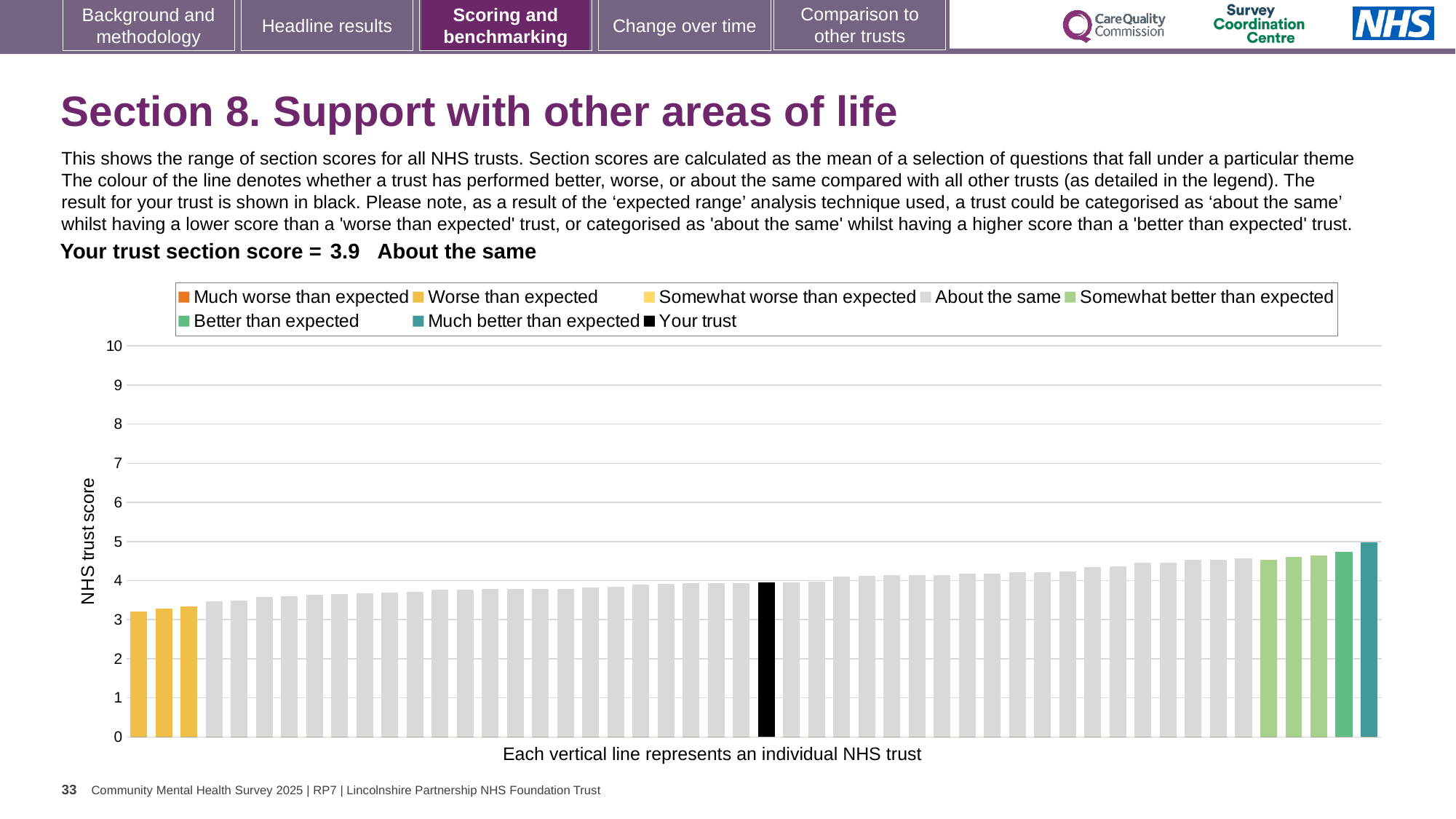
Which legend category does the shortest bar on the chart belong to? Worse than expected Is the value of the shortest bar on the chart greater or less than 4? less Which legend category does the tallest bar on the chart belong to? Much better than expected Do the bar values rise or fall from left to right across the chart? rise Is the value of the black 'Your trust' bar greater or less than 5? less What kind of chart is shown on the slide? bar chart Which category is your trust's section score placed in? About the same Is the value of the tallest bar (Much better than expected) greater or less than 4? greater What is the title of the vertical axis? NHS trust score How many bars are coloured as 'Worse than expected'? 3 How many entries does the chart legend list? 8 What is the section score for your trust? 3.9